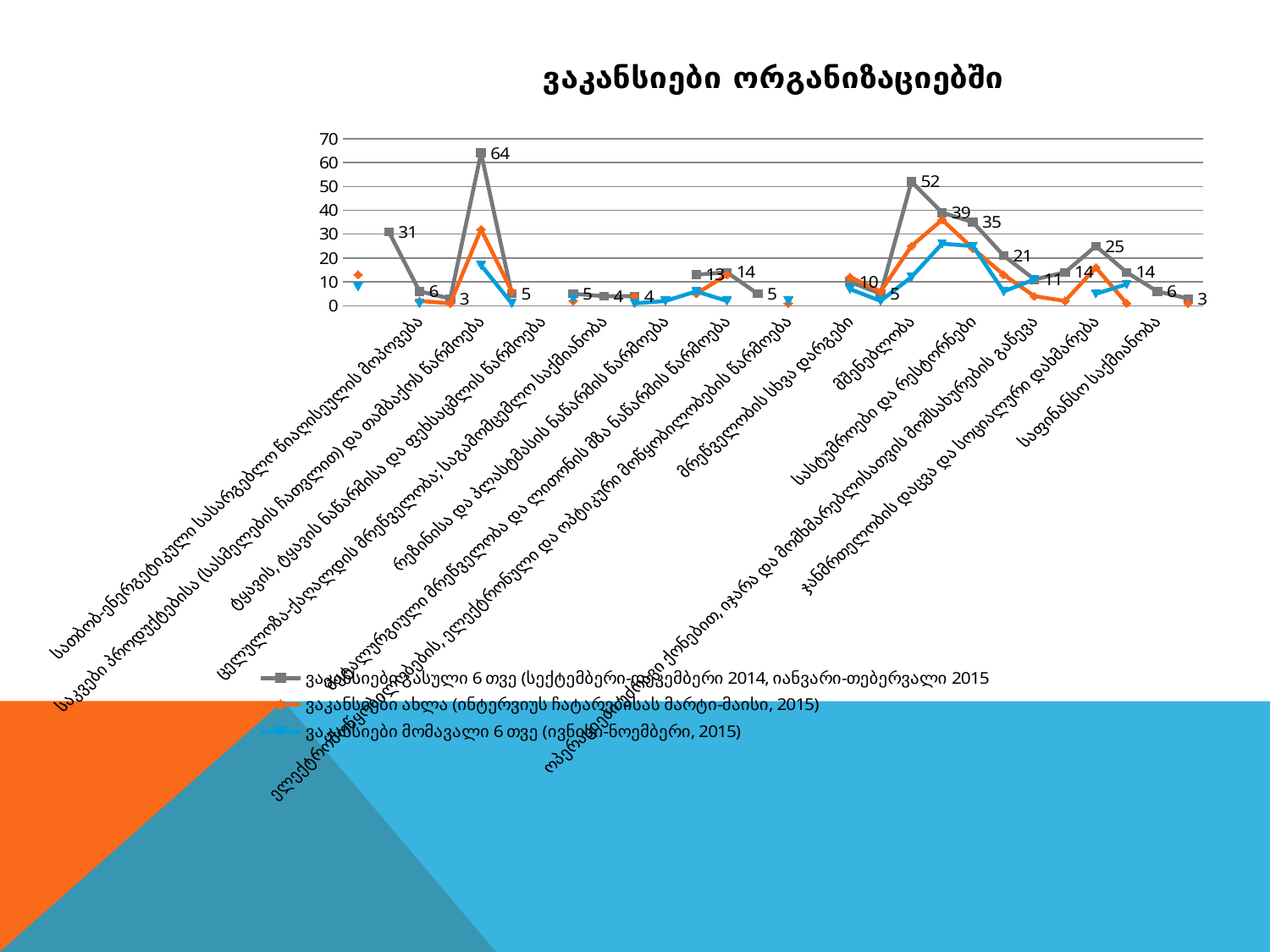
What is the highest value shown on the vertical axis? 70 What is the lowest data label shown on the chart? 3 What is the highest data label shown on the chart? 64 Is the value labeled 25 greater or less than 20? greater How many series does the legend list? 3 What kind of chart is shown on the slide? line chart Which is larger, the peak labeled 64 or the peak labeled 52? 64 Is the highest labeled value on the chart greater or less than 60? greater What is the difference between the labeled values 39 and 35? 4 What is the difference between the two highest labeled peaks, 64 and 52? 12 What is the title of the chart? ვაკანსიები ორგანიზაციებში